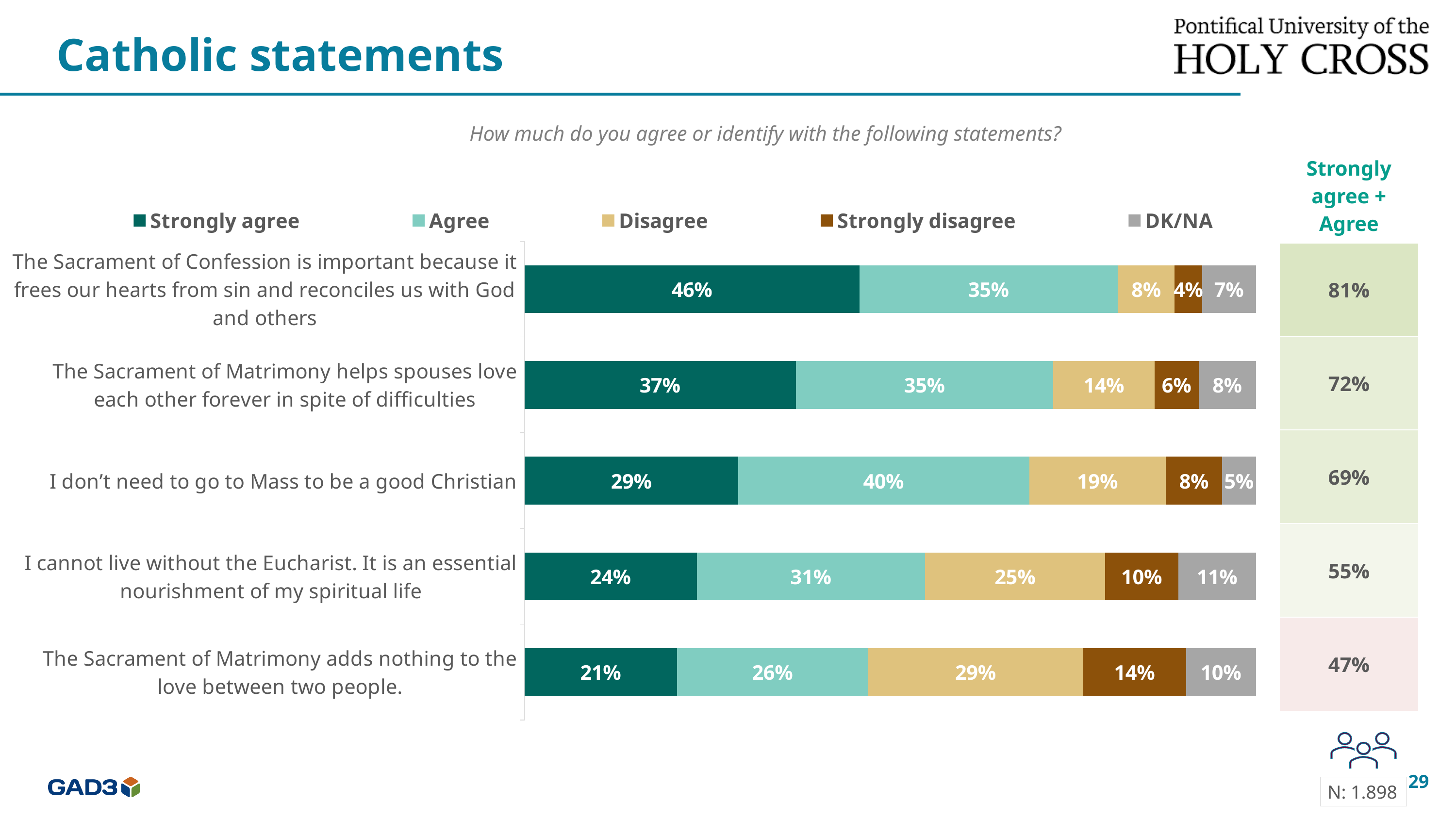
Which is larger: the Agree percentage for "I don't need to go to Mass to be a good Christian" or the Agree percentage for "The Sacrament of Matrimony adds nothing to the love between two people."? I don't need to go to Mass to be a good Christian How many statements are shown in the chart? 5 What is the combined Strongly agree + Agree value for "The Sacrament of Matrimony helps spouses love each other forever in spite of difficulties"? 72% What kind of chart is shown on the slide? Stacked bar chart Which statement has the highest Strongly agree percentage? The Sacrament of Confession is important because it frees our hearts from sin and reconciles us with God and others What is the DK/NA percentage for "I don't need to go to Mass to be a good Christian"? 5% How many series does the legend list? 5 What percentage disagree with the statement "I cannot live without the Eucharist. It is an essential nourishment of my spiritual life"? 25% What percentage strongly agree that the Sacrament of Confession is important because it frees our hearts from sin and reconciles us with God and others? 46% Which statement has the highest Strongly disagree percentage? The Sacrament of Matrimony adds nothing to the love between two people. What is the difference between the Strongly agree percentages for the Confession statement (46%) and the Eucharist statement (24%)? 22% Which statement has the lowest Strongly agree + Agree value? The Sacrament of Matrimony adds nothing to the love between two people.